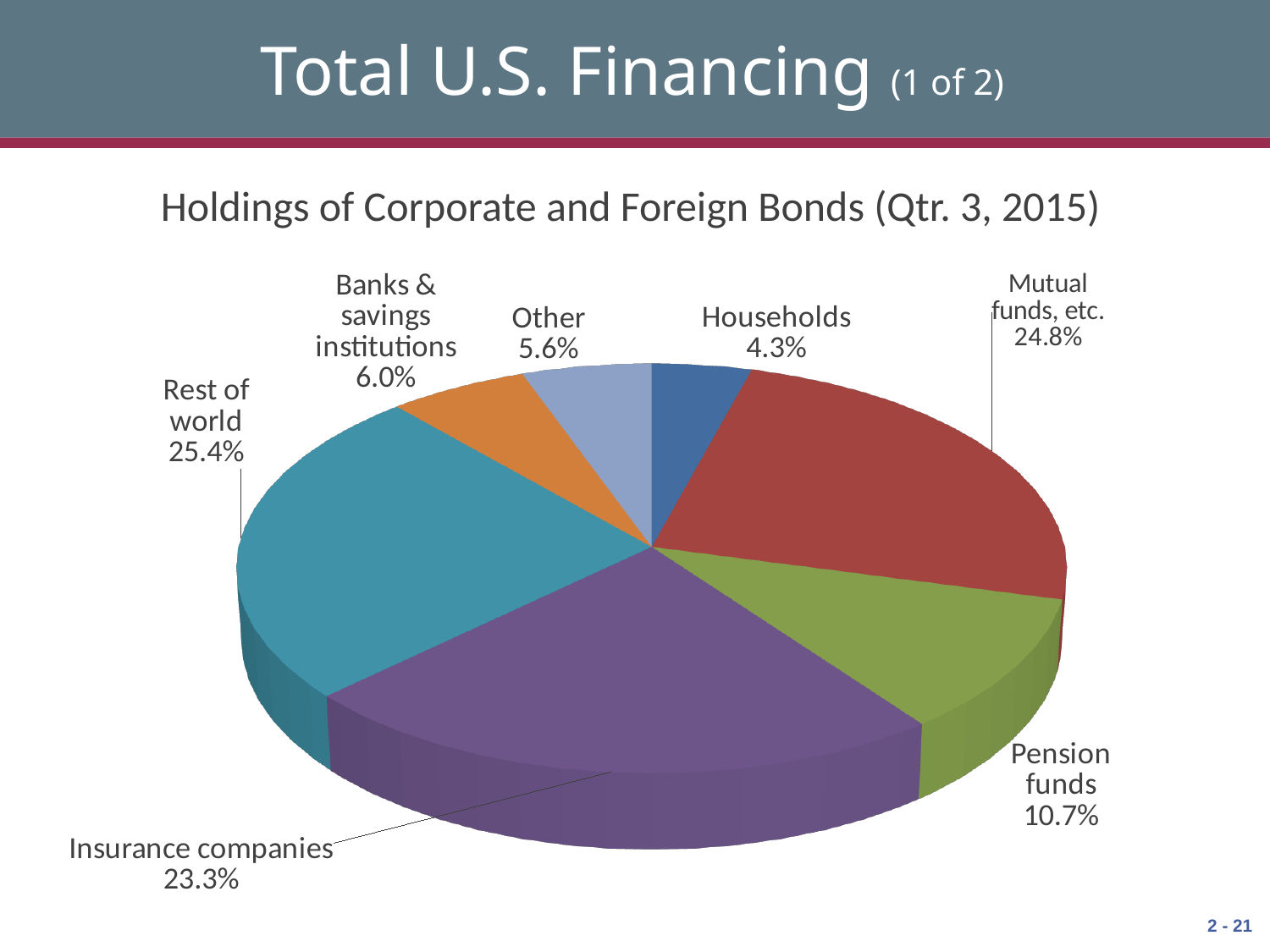
How many categories are shown in the pie chart? 7 What is the difference in percentage points between Mutual funds, etc. and Pension funds? 14.1 What is the combined share of Households and Other? 9.9% What is the value shown for Pension funds? 10.7% What is the title of the chart? Holdings of Corporate and Foreign Bonds (Qtr. 3, 2015) Which category holds the smallest share of corporate and foreign bonds? Households What percentage of the pie is Insurance companies? 23.3% Which category holds the largest share of corporate and foreign bonds? Rest of world What type of chart is shown on the slide? Pie chart Which is larger, the share for Other or the share for Banks & savings institutions? Banks & savings institutions What share is held by Banks & savings institutions? 6.0% What share of holdings of corporate and foreign bonds is held by Rest of world? 25.4%